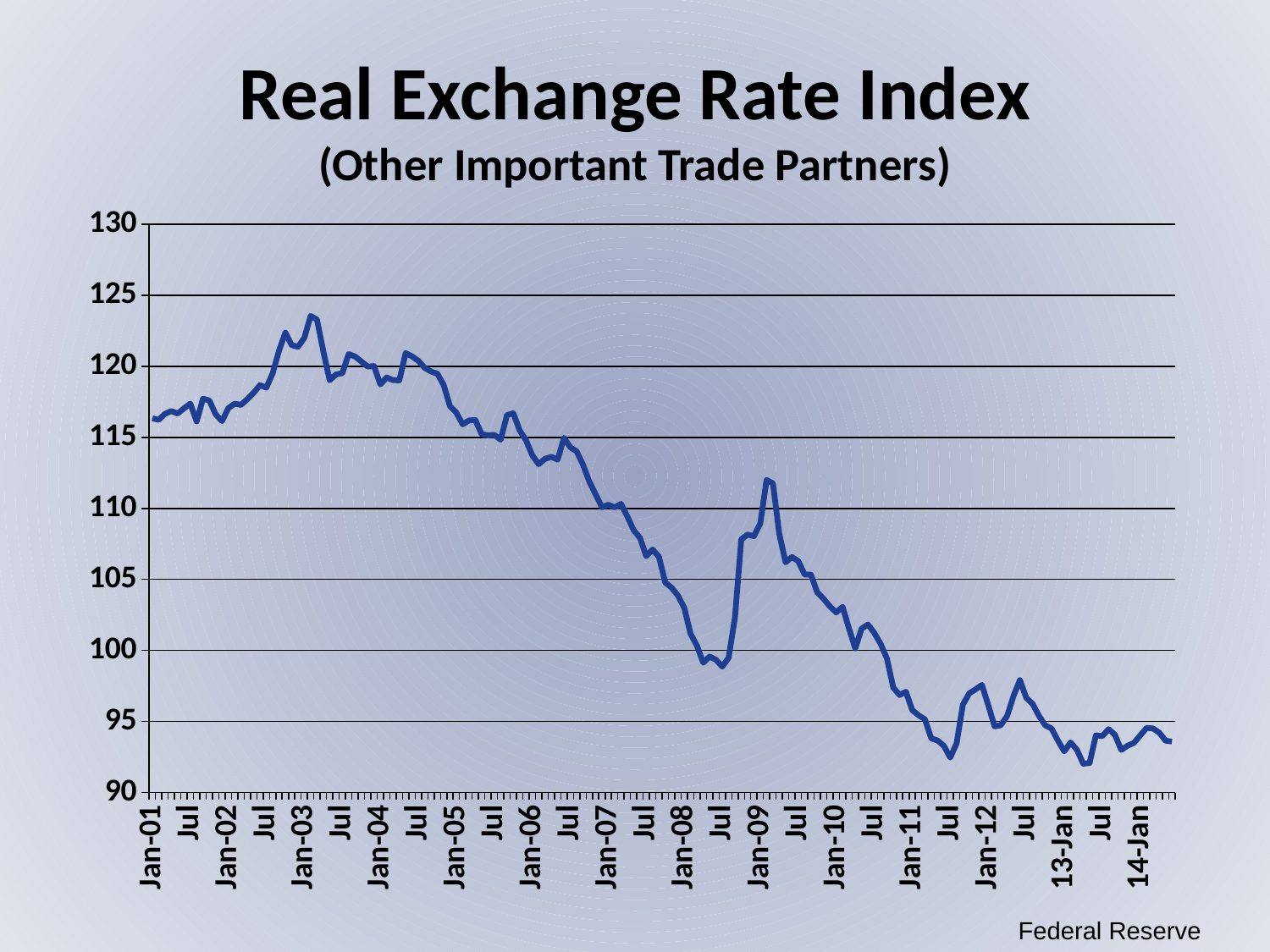
Which is larger, the value for Jan-01 or the value for Jan-12? Jan-01 Is the value for Jan-08 greater or less than 110? less Is the value for Jan-11 greater or less than 100? less What is the title of the chart? Real Exchange Rate Index (Other Important Trade Partners) Does the index rise or fall between Jul-08 and Jan-09? rise Is the value for Jan-01 greater or less than 110? greater Overall, does the Real Exchange Rate Index rise or fall from Jan-01 to 14-Jan? fall Does the index rise or fall between Jan-08 and Jul-08? fall What source is cited for the chart data? Federal Reserve In which year does the index reach its highest point? 2003 What kind of chart is shown on the slide? line chart